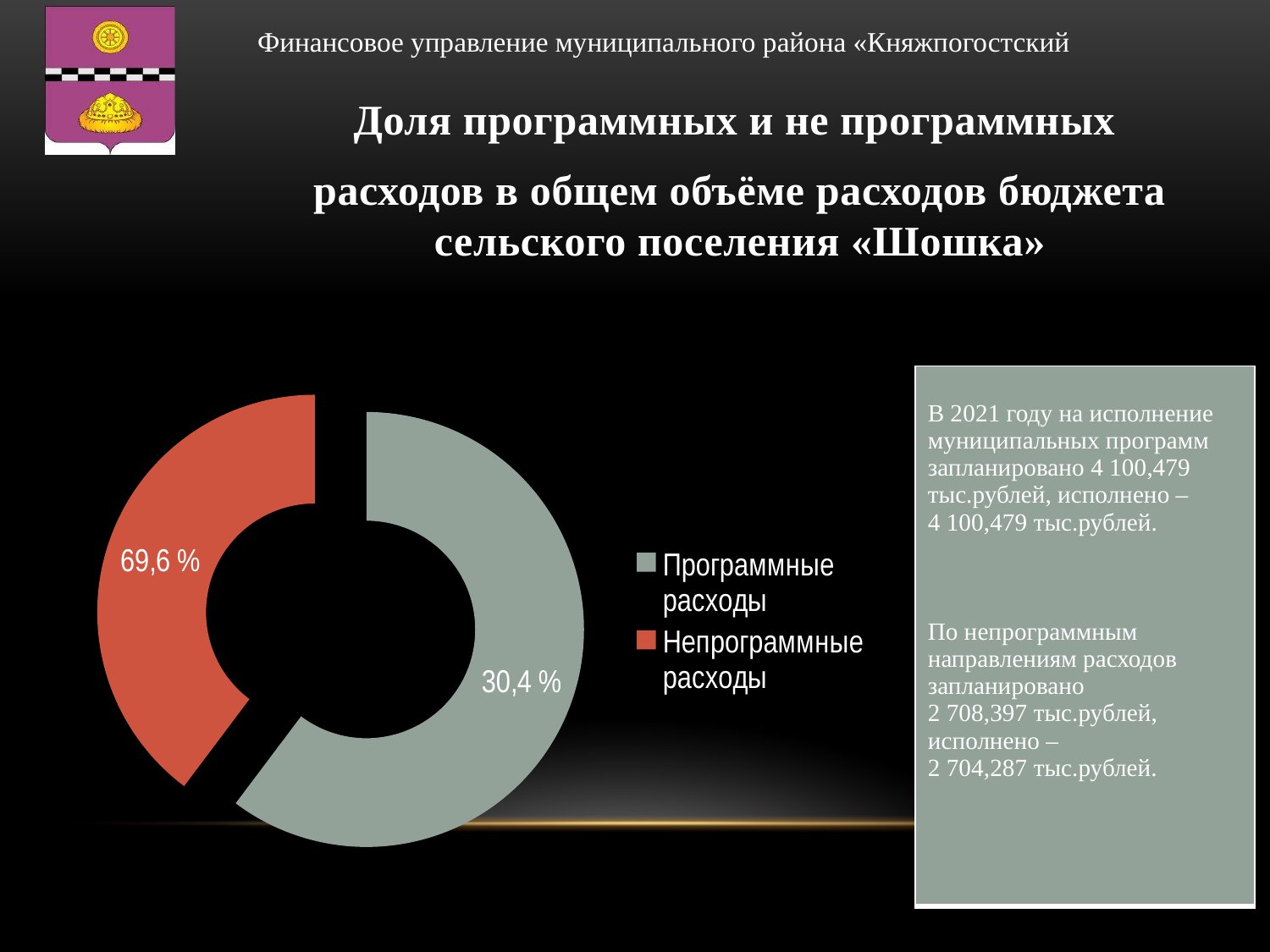
How many entries does the chart legend list? 2 What kind of chart is shown on the slide? doughnut (pie) chart Which colour represents Непрограммные расходы in the chart? red What percentage label is printed on the grey-green slice of the chart? 30,4 % What percentage label is shown for Программные расходы? 30,4 % What percentage label is shown for Непрограммные расходы? 69,6 % What are the two legend entries of the chart? Программные расходы; Непрограммные расходы What percentage label is printed on the red slice of the chart? 69,6 % How many slices does the doughnut chart have? 2